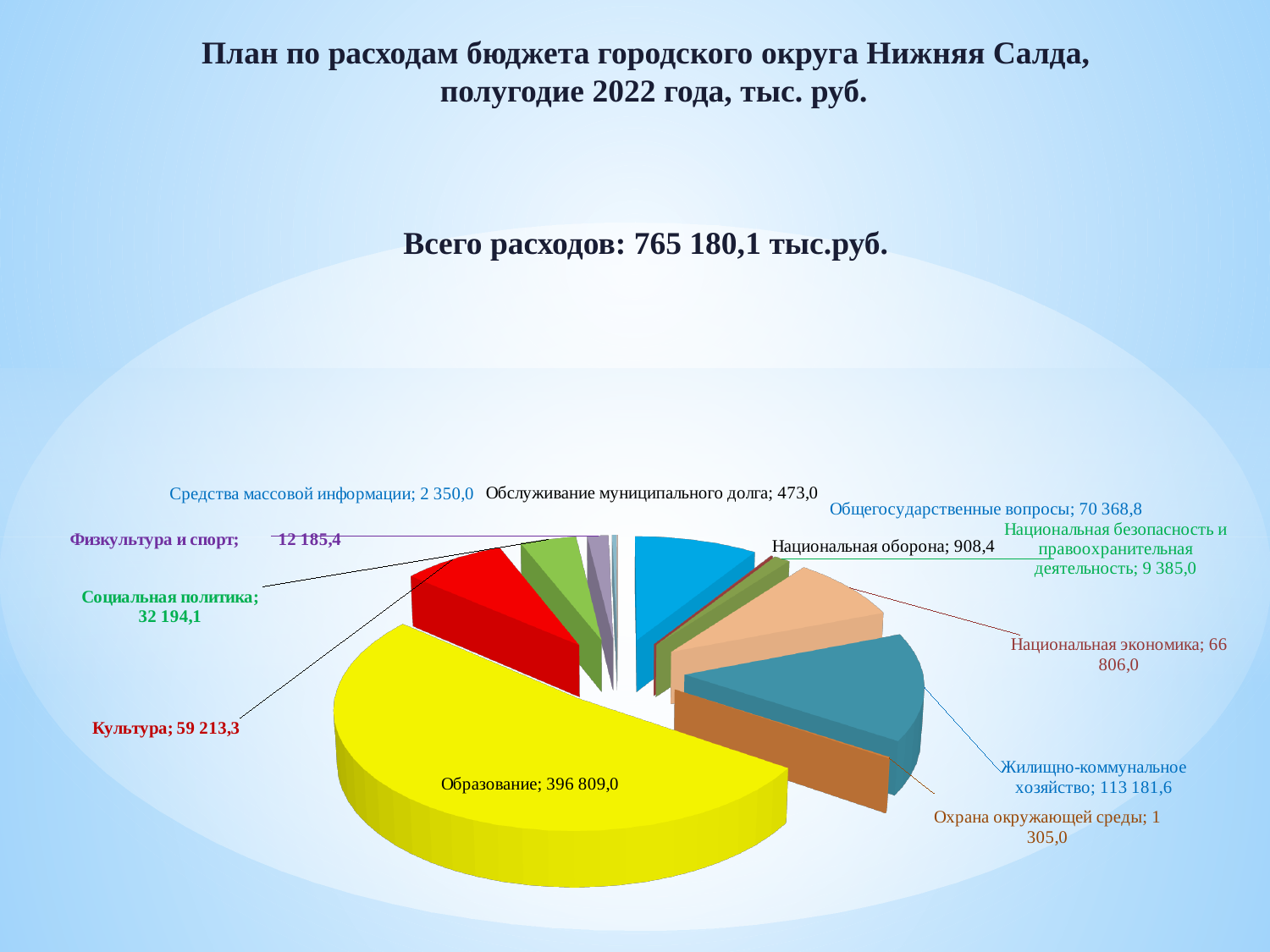
Which category has the smallest value in the pie chart? Обслуживание муниципального долга What is the value for Образование? 396 809,0 What total expenditure (Всего расходов) is stated on the slide? 765 180,1 тыс.руб. What is the difference between Жилищно-коммунальное хозяйство and Общегосударственные вопросы? 42 812,8 How many categories (slices) does the pie chart show? 12 Which category has the largest value in the pie chart? Образование What is the value for Национальная безопасность и правоохранительная деятельность? 9 385,0 What is the value for Жилищно-коммунальное хозяйство? 113 181,6 What type of chart is shown on the slide? Pie chart What is the difference between Культура and Социальная политика? 27 019,2 What is the value for Обслуживание муниципального долга? 473,0 Which is larger, Общегосударственные вопросы or Национальная экономика? Общегосударственные вопросы